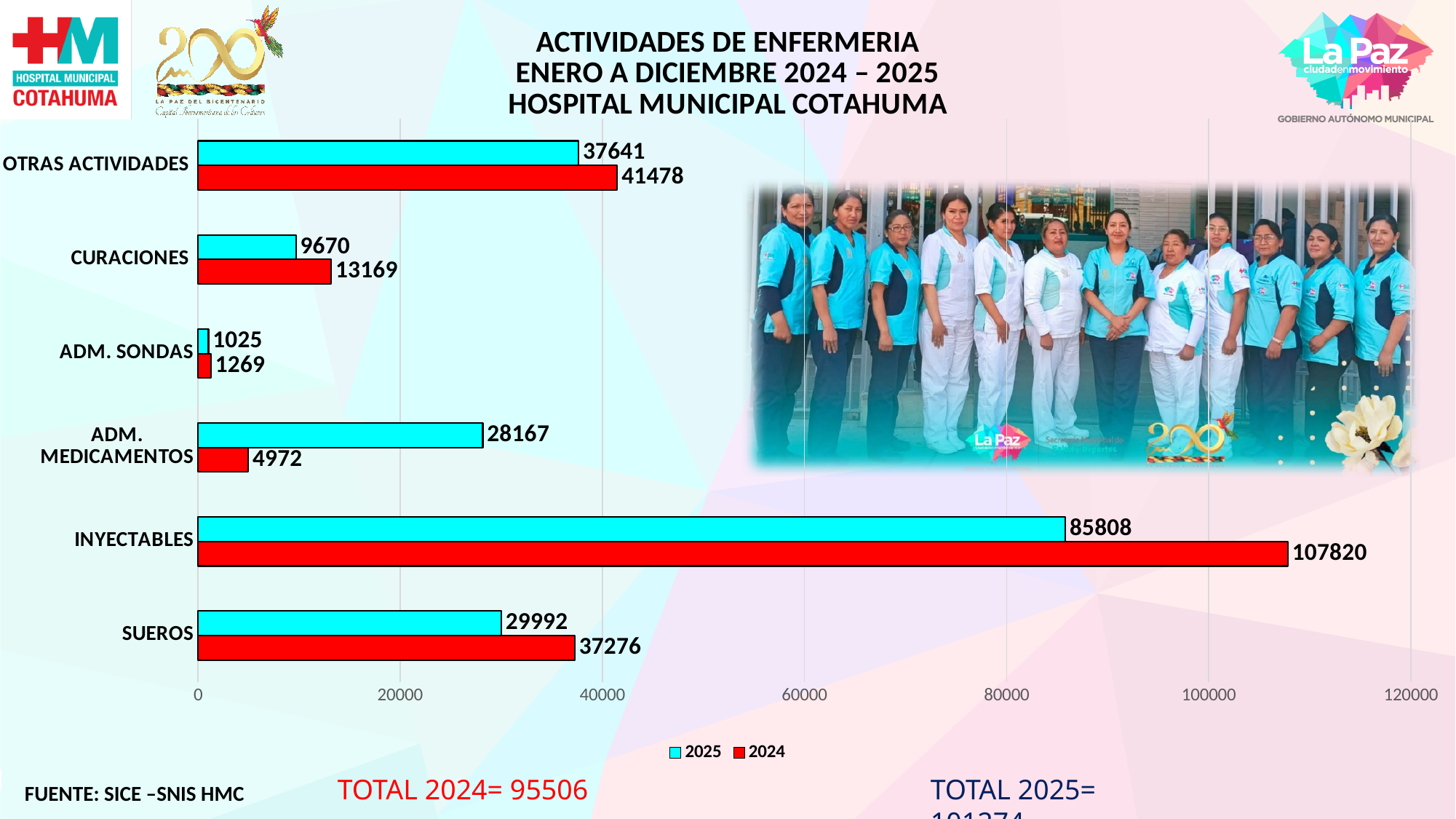
Which category has the lowest 2025 value? ADM. SONDAS What is the 2024 value for INYECTABLES? 107820 What is the 2025 value for ADM. MEDICAMENTOS? 28167 Is the 2025 value for INYECTABLES greater or less than 80000? greater Which category has the highest 2024 value? INYECTABLES Which colour represents the 2024 series in the chart? red What is the difference between the 2024 and 2025 values for SUEROS? 7284 What kind of chart is shown on the slide? bar chart Which is larger for ADM. MEDICAMENTOS, the 2024 value or the 2025 value? 2025 How many series does the legend list? 2 How many categories are shown on the chart? 6 What is the 2025 value for CURACIONES? 9670